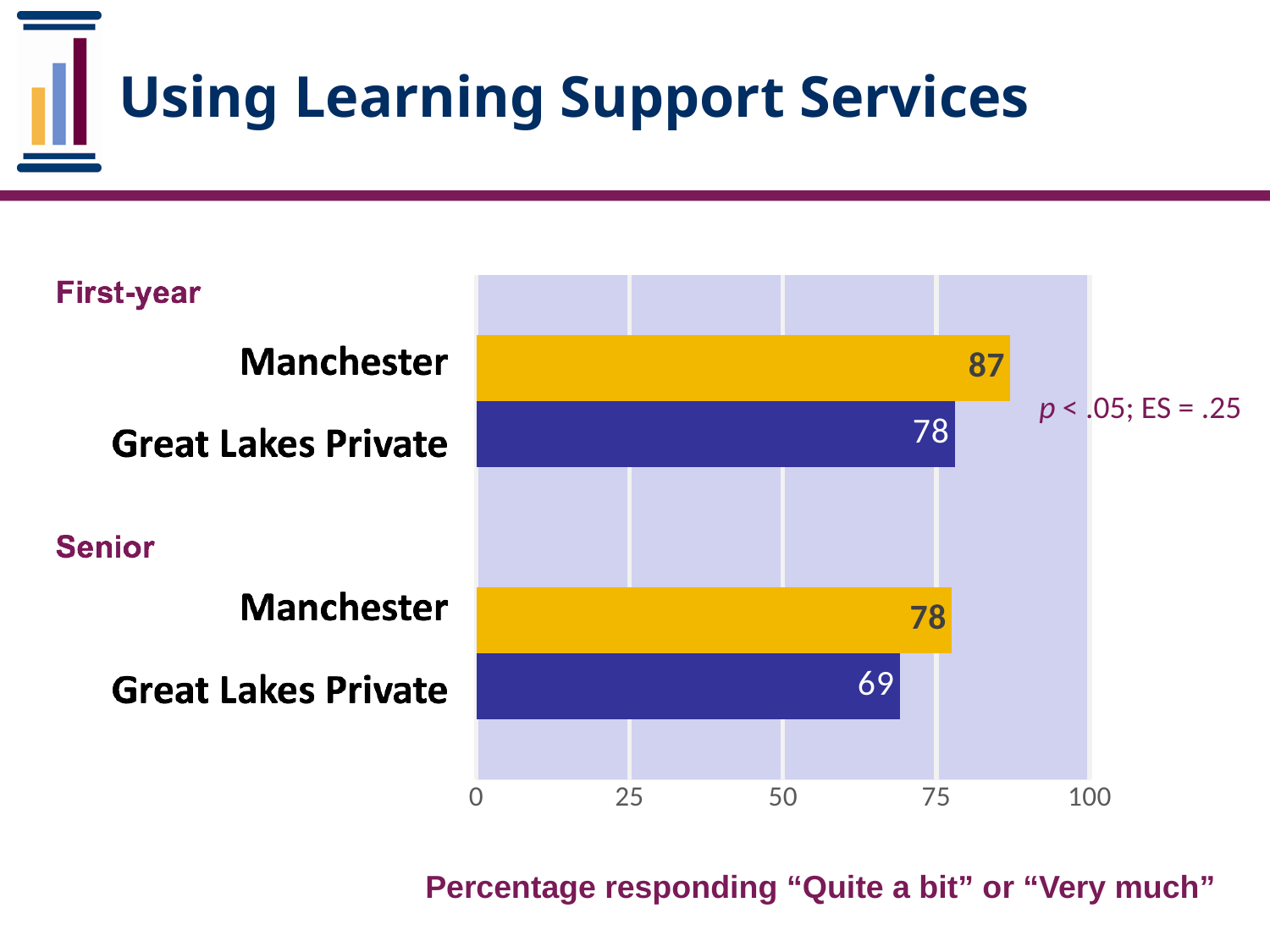
What is the value for First-year Manchester? 87 How many bars are plotted in the chart? 4 What is the value for Senior Manchester? 78 What kind of chart is shown on the slide? bar chart What is the difference between First-year Manchester and First-year Great Lakes Private? 9 Which bar has the highest value? First-year Manchester What is the title of the slide? Using Learning Support Services What is the difference between Senior Manchester and Senior Great Lakes Private? 9 What is the value for Senior Great Lakes Private? 69 Which bar has the lowest value? Senior Great Lakes Private What is the value for First-year Great Lakes Private? 78 Which is larger, First-year Manchester or Senior Manchester? First-year Manchester